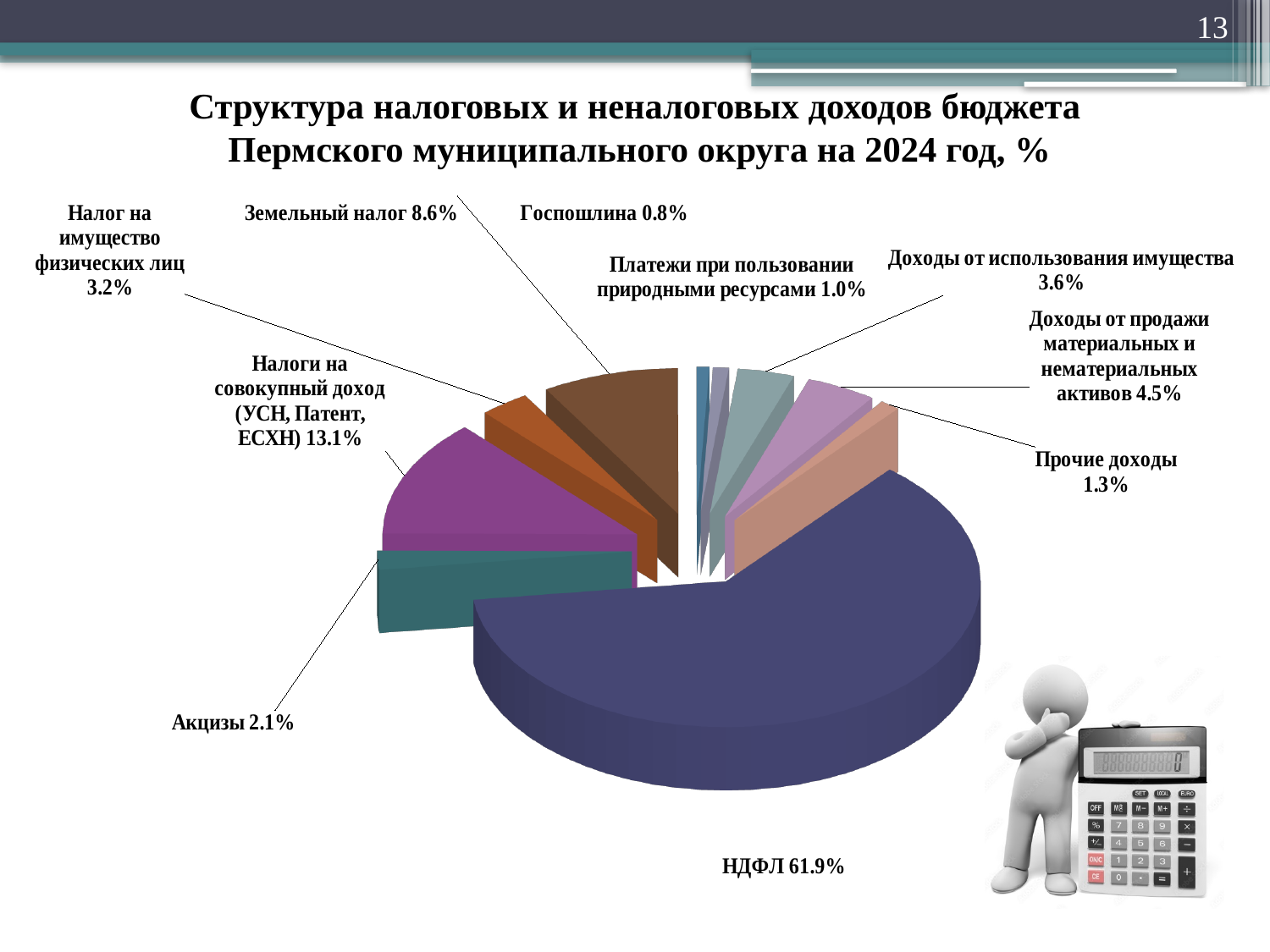
How many categories (slices) does the pie chart have? 10 What kind of chart is shown on the slide? Pie chart Which category has the largest share of the pie? НДФЛ What year does the chart title refer to? 2024 Which is larger: Доходы от использования имущества or Налог на имущество физических лиц? Доходы от использования имущества What percentage is shown for Налоги на совокупный доход (УСН, Патент, ЕСХН)? 13.1% What is the value shown for Акцизы? 2.1% What share of the budget revenue does НДФЛ account for? 61.9% What is the value for Доходы от продажи материальных и нематериальных активов? 4.5% What is the value shown for Земельный налог? 8.6% Which category has the smallest share of the pie? Госпошлина What is the difference between the shares of Налоги на совокупный доход (УСН, Патент, ЕСХН) and Земельный налог? 4.5%